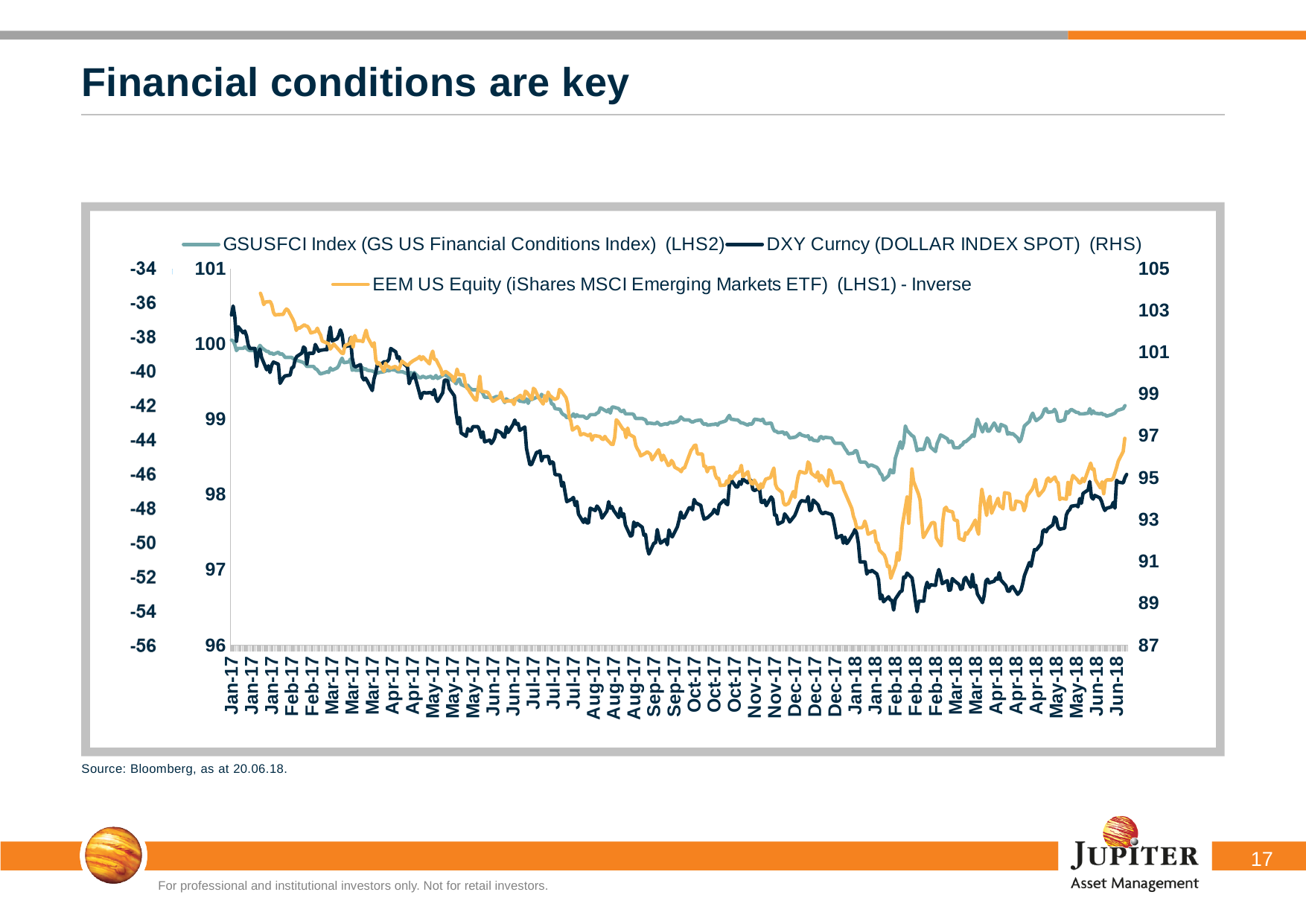
Is the lowest point of the DXY Curncy (DOLLAR INDEX SPOT) line, around Feb-18, greater or less than 91 on the right-hand axis? less Is the DXY Curncy (DOLLAR INDEX SPOT) value at the end of the chart (Jun-18) greater or less than 93 on the right-hand axis? greater Does the DXY Curncy (DOLLAR INDEX SPOT) line rise or fall between Feb-18 and Jun-18? Rise Which series is plotted on the right-hand axis (RHS)? DXY Curncy (DOLLAR INDEX SPOT) Does the EEM US Equity (iShares MSCI Emerging Markets ETF) inverse line end higher or lower in Jun-18 than it started in Jan-17? Lower Is the DXY Curncy (DOLLAR INDEX SPOT) value at the start of the chart (Jan-17) greater or less than 101 on the right-hand axis? greater How many series does the chart's legend list? 3 What kind of chart is shown on the slide? Line chart Does the GSUSFCI Index line end higher or lower in Jun-18 than it started in Jan-17? Lower What colour is the DXY Curncy (DOLLAR INDEX SPOT) line? Dark navy